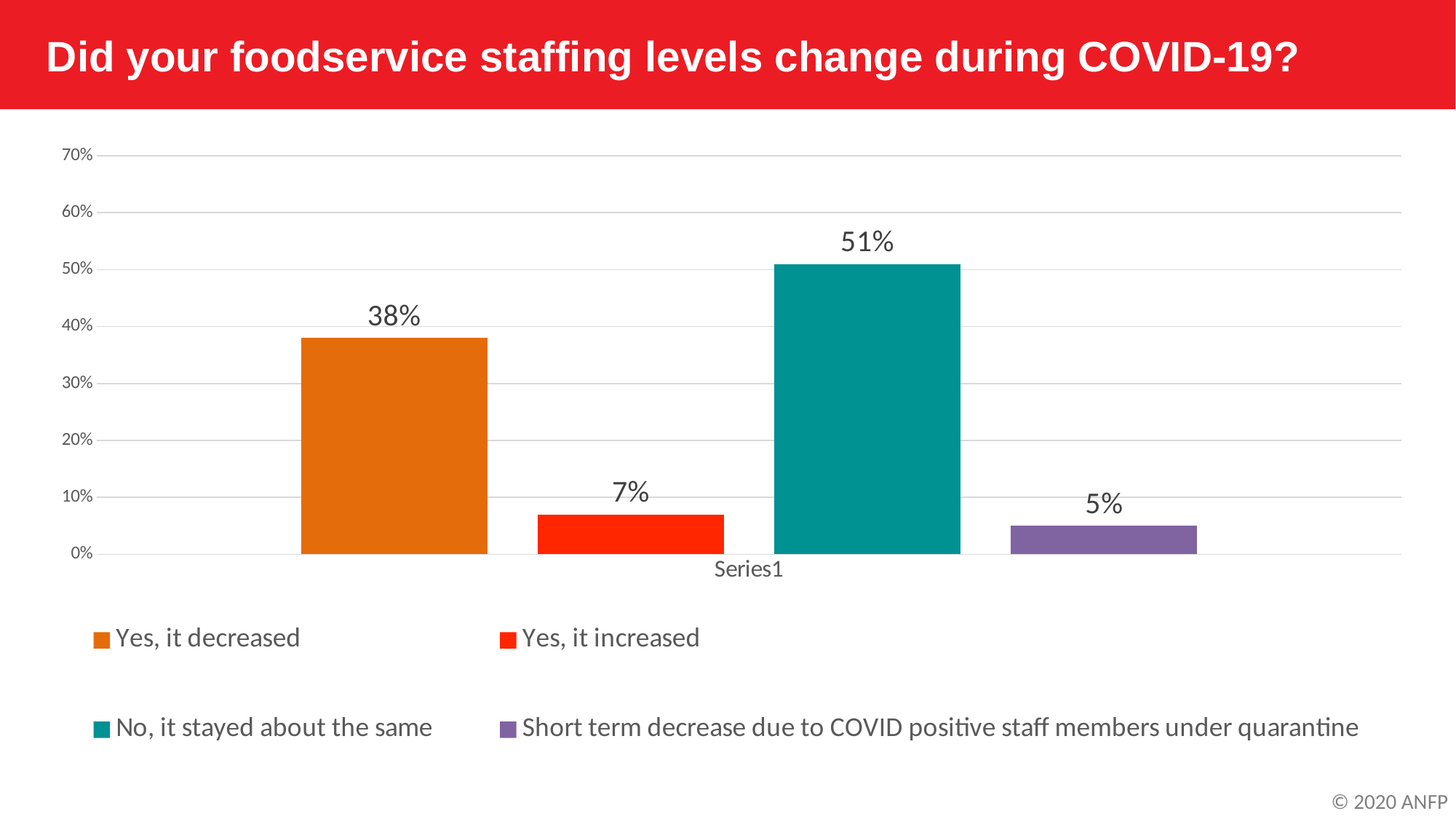
Is the value for 'No, it stayed about the same' greater or less than 50%? greater Which response has the highest percentage? No, it stayed about the same What is the difference in percentage points between 'No, it stayed about the same' and 'Yes, it decreased'? 13 Which is larger: the percentage for 'Yes, it increased' or for 'Yes, it decreased'? Yes, it decreased Which response has the lowest percentage? Short term decrease due to COVID positive staff members under quarantine What percentage of respondents said staffing stayed about the same? 51% How many response categories are shown in the chart? 4 What percentage of respondents said their foodservice staffing levels decreased during COVID-19? 38% What type of chart is shown on the slide? Bar chart What percentage of respondents said their staffing levels increased? 7% What percentage reported a short term decrease due to COVID positive staff members under quarantine? 5% What is the title of the slide? Did your foodservice staffing levels change during COVID-19?